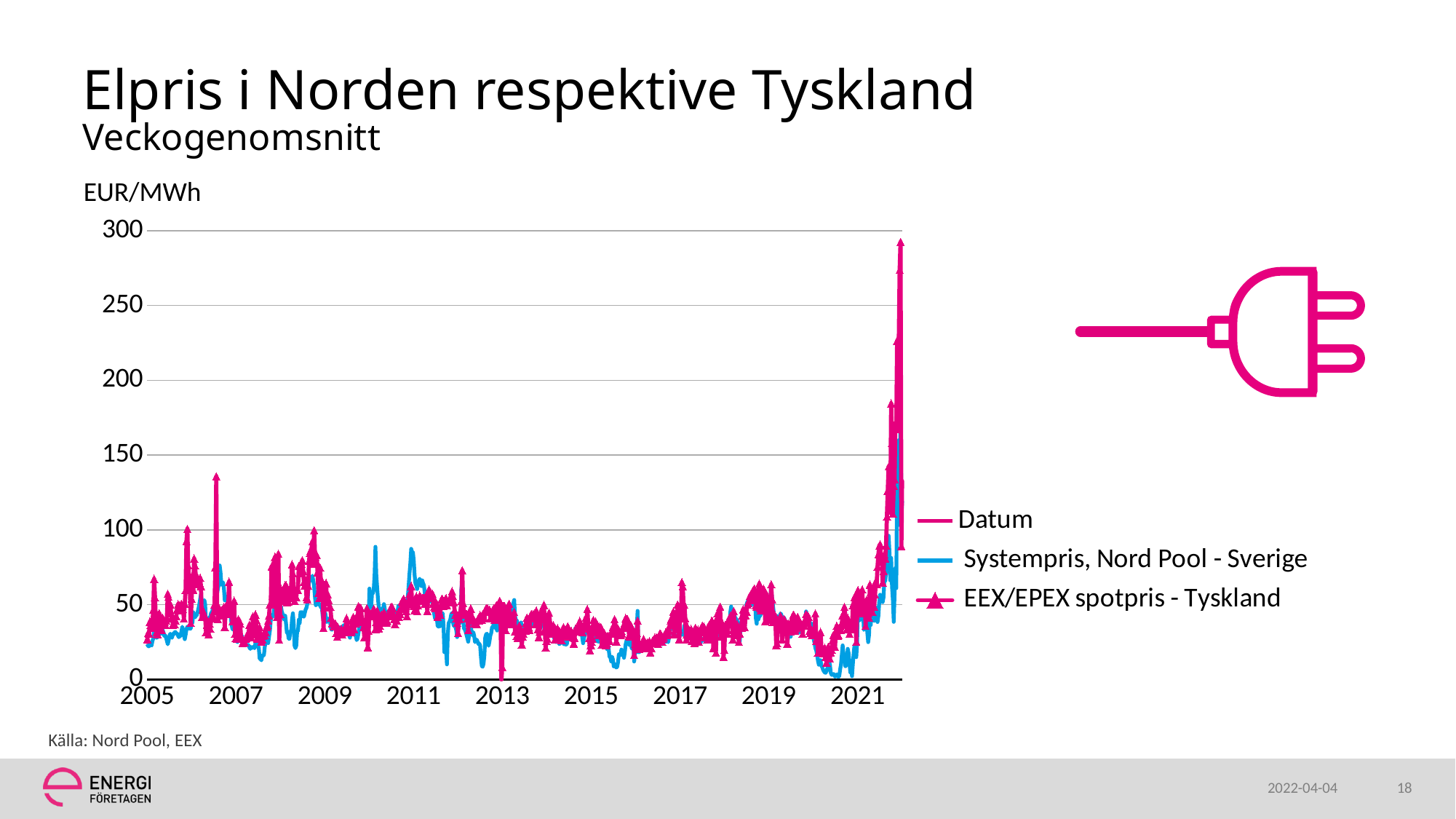
How many year labels are shown on the horizontal axis? 9 What is the highest value shown on the vertical axis? 300 Is the peak value of EEX/EPEX spotpris - Tyskland in late 2021 greater or less than 250? greater Which series reaches the highest value on the chart? EEX/EPEX spotpris - Tyskland What kind of chart is shown on the slide? Line chart Is the peak value of Systempris, Nord Pool - Sverige in late 2021 greater or less than 100? greater Is the spike in EEX/EPEX spotpris - Tyskland around 2006 greater or less than 100? greater How many series does the legend list? 3 What unit is shown above the vertical axis? EUR/MWh Do the prices rise or fall from 2020 to the end of 2021? Rise